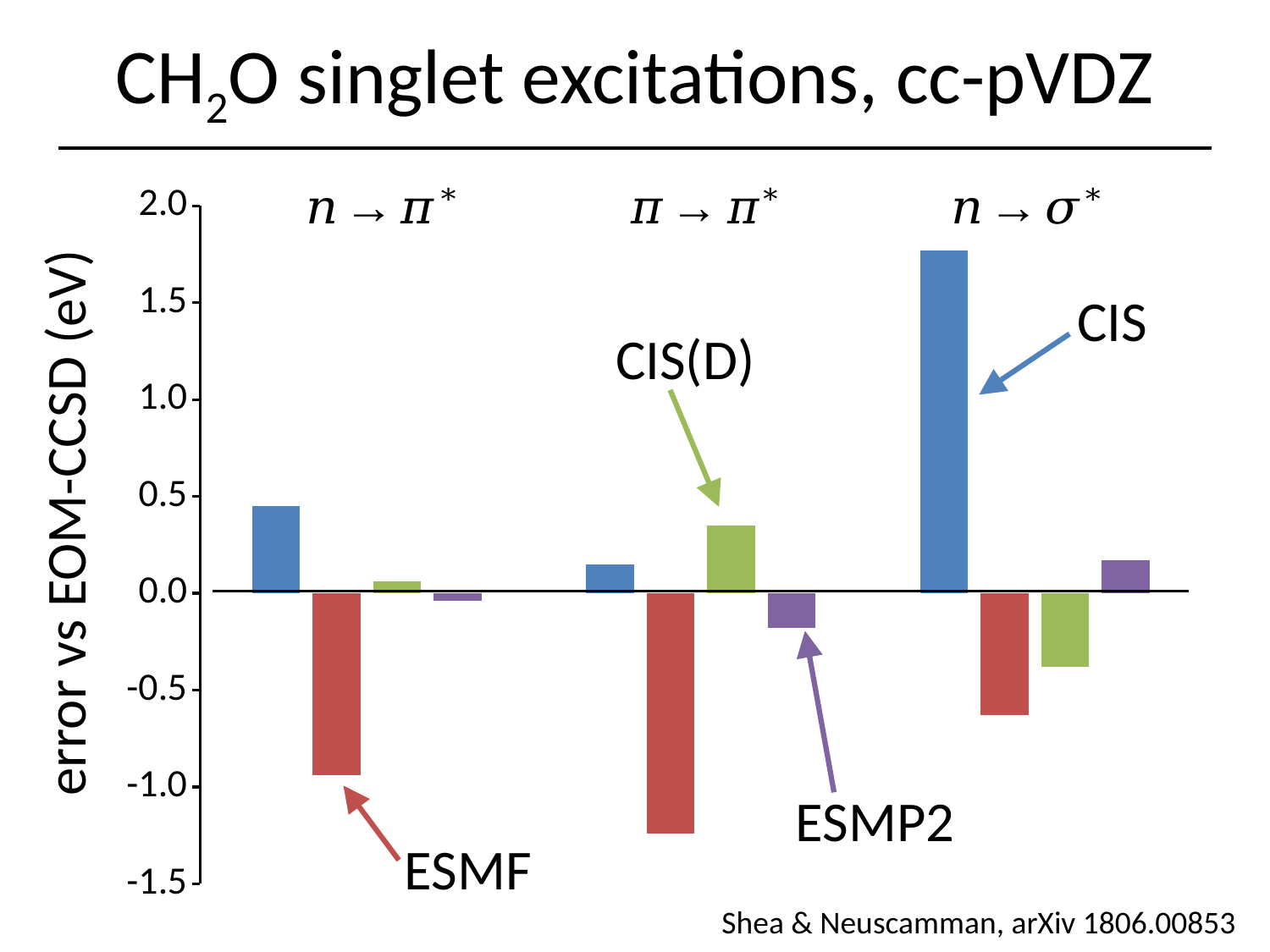
What is the label of the y axis? error vs EOM-CCSD (eV) How many methods are labelled on the chart? 4 Is the CIS(D) error for the π → π* excitation greater or less than 0.5 eV? less Is the CIS error for the n → σ* excitation greater or less than 1.5 eV? greater For the π → π* excitation, which has the larger error, CIS or CIS(D)? CIS(D) For which excitation is the CIS error the largest? n → σ* Is the ESMF error for the π → π* excitation greater or less than -1.0 eV? less Which method has the most negative error for the π → π* excitation? ESMF How many excitation categories are shown along the x axis? 3 What kind of chart is shown on the slide? bar chart Which method has the largest positive error for the n → σ* excitation? CIS